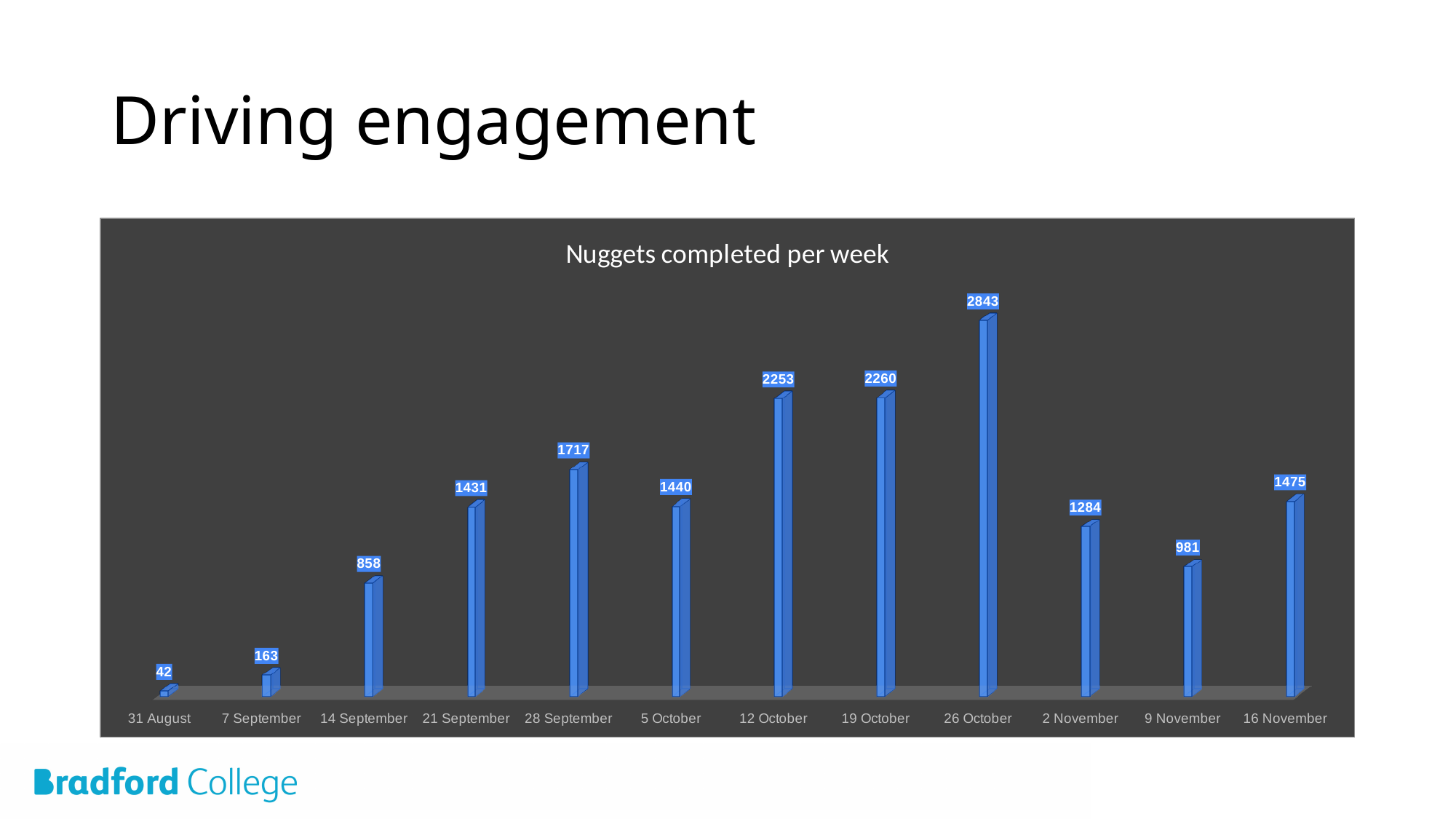
What kind of chart is shown on the slide? bar chart What is the value for 14 September? 858 What is the title of the chart? Nuggets completed per week What is the difference between the values for 7 September and 31 August? 121 Which is larger, the value for 28 September or the value for 5 October? 28 September Which is larger, the value for 9 November or the value for 2 November? 2 November What is the difference between the values for 26 October and 2 November? 1559 Which week has the lowest number of nuggets completed? 31 August What is the value for 16 November? 1475 Which week has the highest number of nuggets completed? 26 October How many weeks are shown on the x axis? 12 What is the value for 26 October? 2843